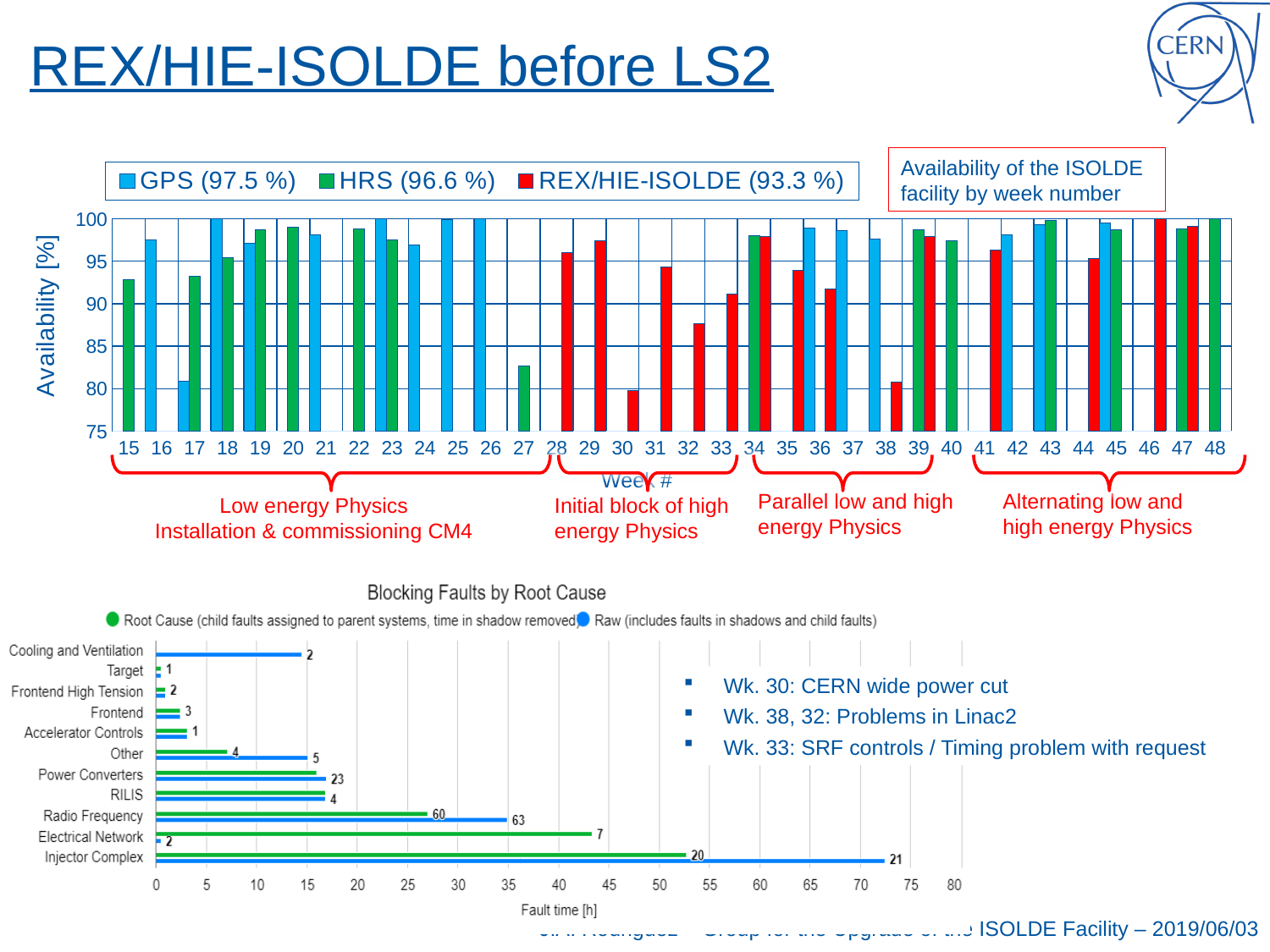
In the 'Availability of the ISOLDE facility by week number' chart, is the REX/HIE-ISOLDE value for week 32 greater or less than 90? less How many series does the legend of the 'Availability of the ISOLDE facility by week number' chart list? 3 In the 'Blocking Faults by Root Cause' chart, which category has the longest Raw bar? Injector Complex What kind of chart is the 'Availability of the ISOLDE facility by week number' chart? bar chart In the 'Blocking Faults by Root Cause' chart, is the Raw bar for Injector Complex greater or less than 70 hours? greater In the 'Availability of the ISOLDE facility by week number' chart, is the GPS value for week 17 greater or less than 85? less In the 'Availability of the ISOLDE facility by week number' chart, what availability percentage is shown in the legend for HRS? 96.6 % How many categories are shown on the 'Blocking Faults by Root Cause' chart? 11 What kind of chart is the 'Blocking Faults by Root Cause' chart? bar chart